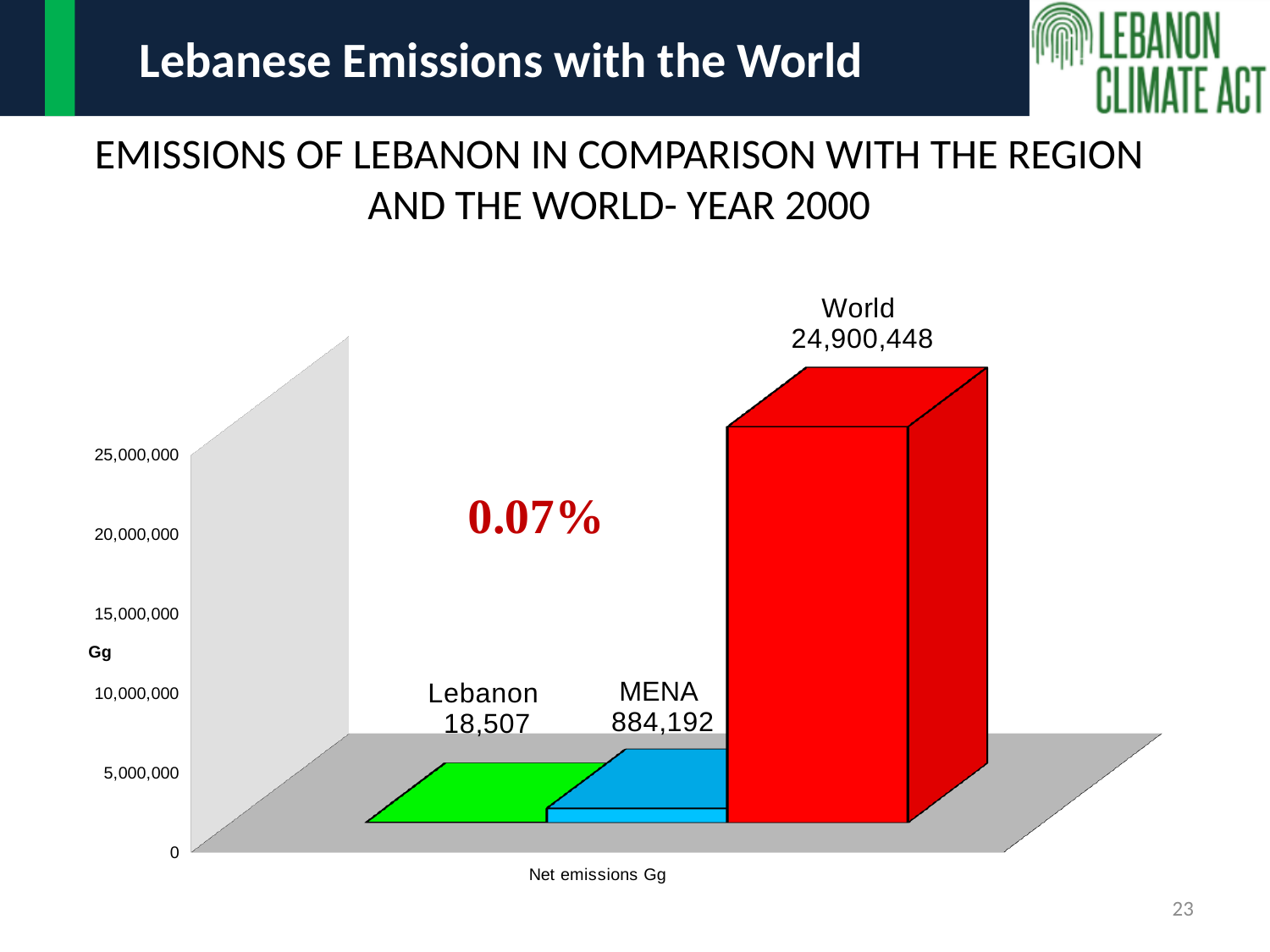
What is the difference between the MENA and Lebanon net emissions values? 865,685 What is the net emissions value for World? 24,900,448 Is the value for World greater or less than 20,000,000? greater What kind of chart is shown on the slide? bar chart What percentage is printed in red on the chart? 0.07% What unit is shown on the vertical axis of the chart? Gg What is the net emissions value for Lebanon? 18,507 How many categories are shown in the chart? 3 Which category has the highest net emissions? World Which has larger net emissions, MENA or Lebanon? MENA Which category has the lowest net emissions? Lebanon What is the net emissions value for MENA? 884,192